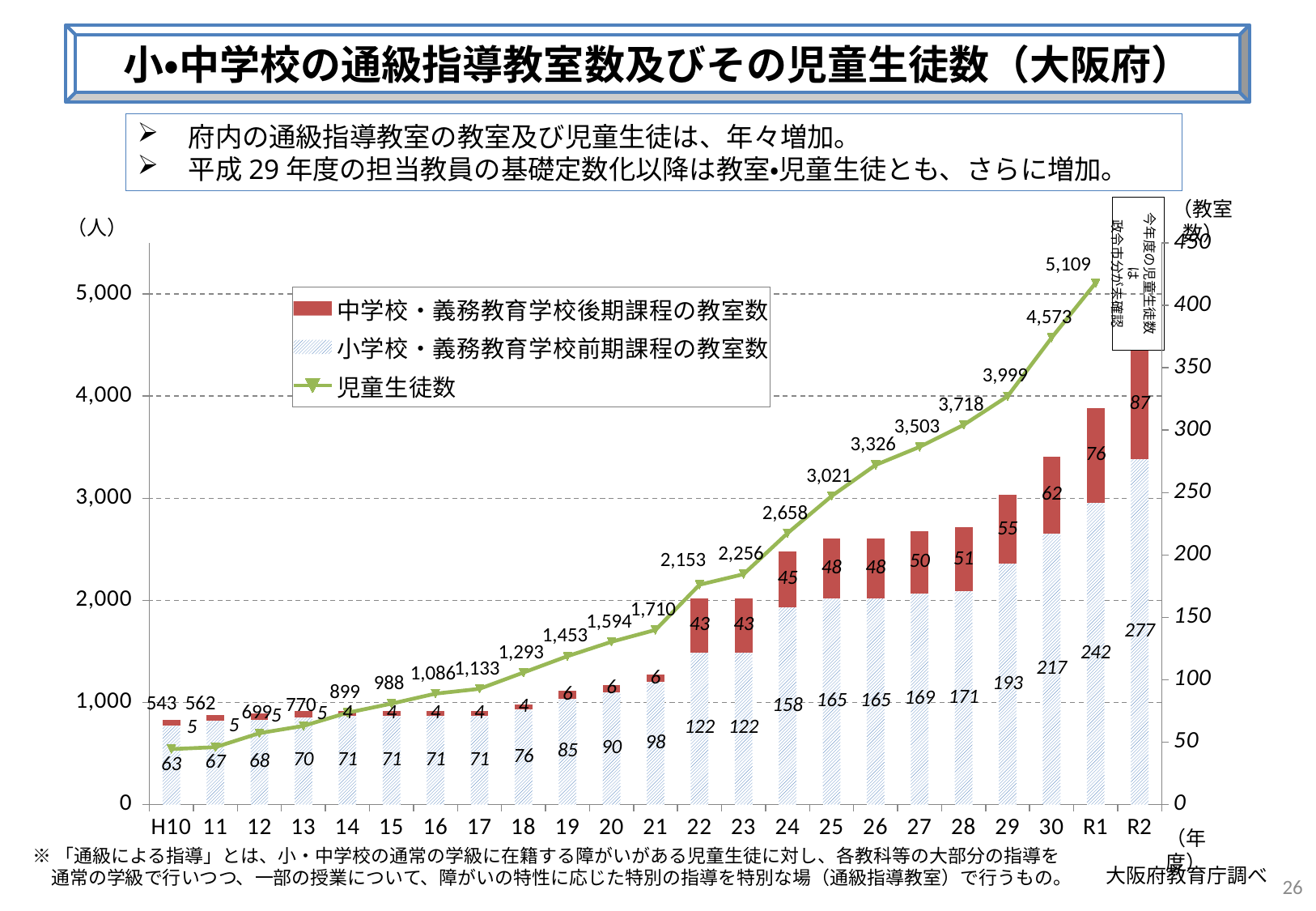
What is the total number of classrooms (both series combined) for R2? 364 What is the 中学校・義務教育学校後期課程の教室数 value for R2? 87 What kind of chart is shown on the slide? stacked bar chart with a line Which year has the highest 小学校・義務教育学校前期課程の教室数 value? R2 What is the difference in 児童生徒数 between R1 and 30? 536 How many series does the legend list? 3 How many years (categories) are shown on the x axis? 23 What is the 児童生徒数 value for R1? 5,109 What is the total number of classrooms (both series combined) for 29? 248 What is the 小学校・義務教育学校前期課程の教室数 value for R2? 277 What is the 児童生徒数 value for H10? 543 Does the 児童生徒数 line rise or fall from H10 to R1? rise